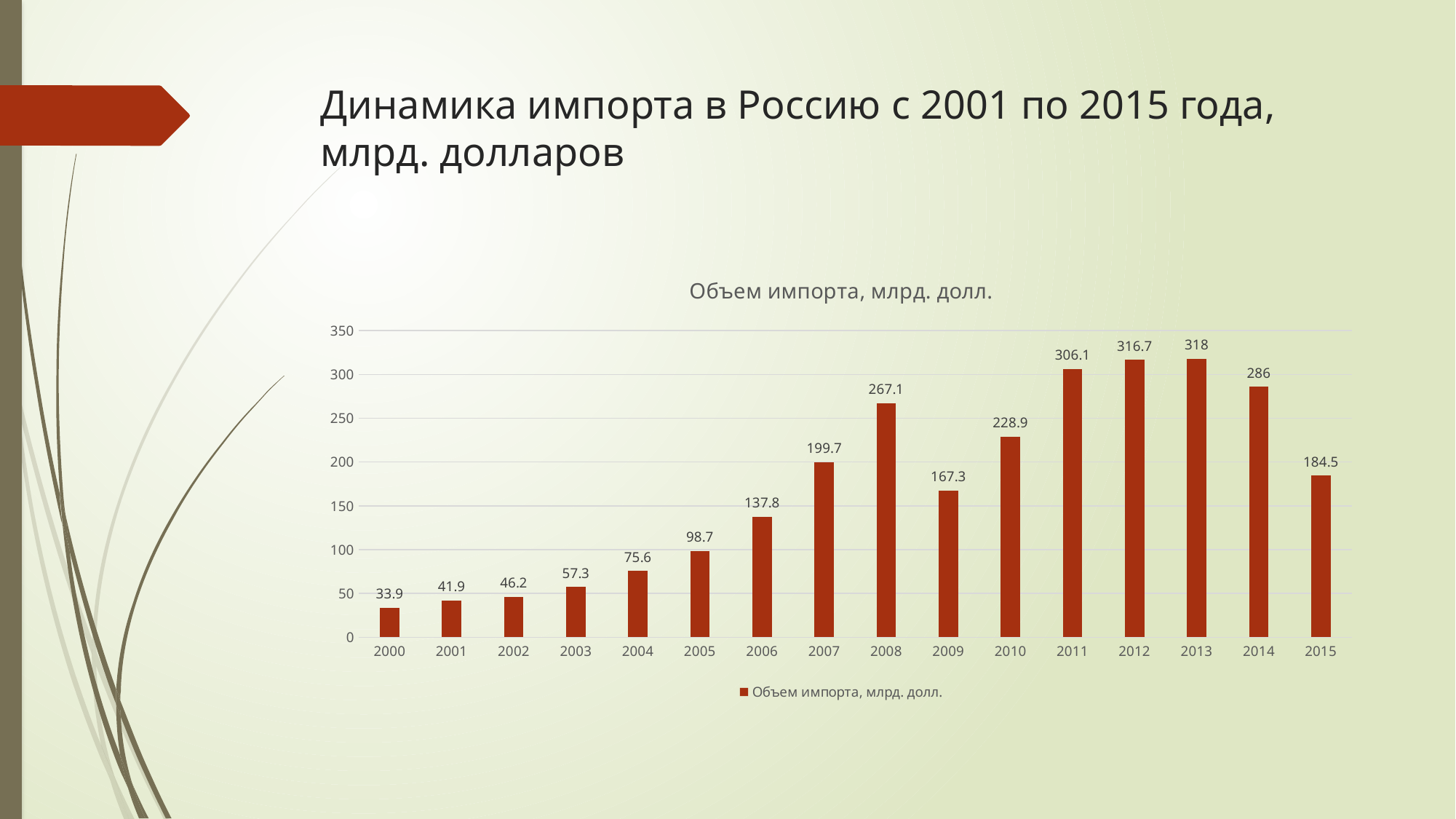
What is the difference between the values for 2008 and 2009? 99.8 Which is larger, the value for 2010 or the value for 2014? 2014 What is the difference between the values for 2013 and 2014? 32 What is the import volume shown for 2008? 267.1 Which year has the lowest import volume? 2000 Is the value for 2007 greater or less than 150? greater What kind of chart is shown on the slide? bar chart What value is labelled for 2015? 184.5 What is the value for 2003? 57.3 Which year has the highest import volume? 2013 How many years are shown on the x axis? 16 What is the title of the chart? Объем импорта, млрд. долл.